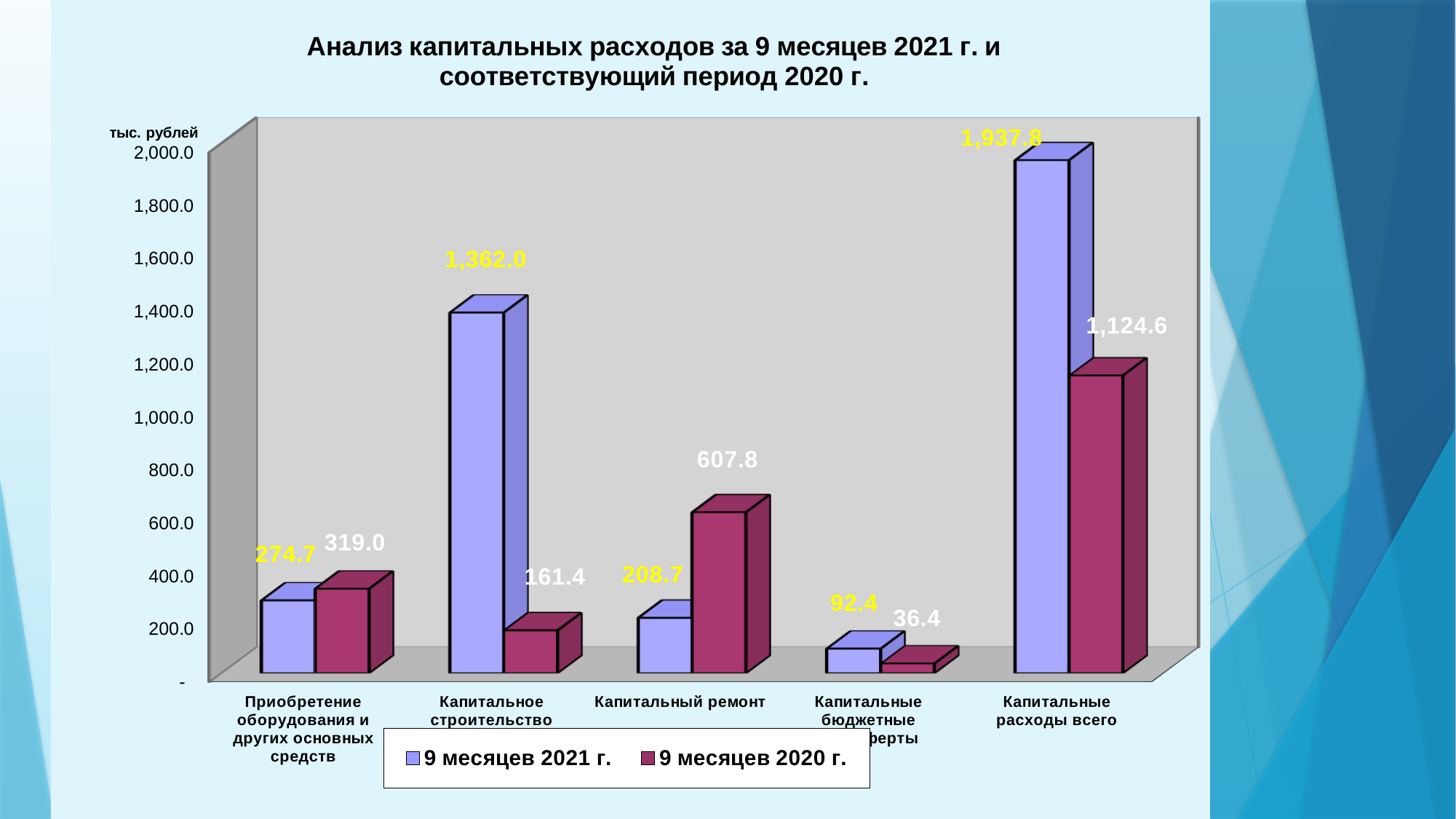
What is the value for "Капитальное строительство" in the "9 месяцев 2021 г." series? 1,362.0 What is the value for "Капитальный ремонт" in the "9 месяцев 2020 г." series? 607.8 What is the value for "Приобретение оборудования и других основных средств" in the "9 месяцев 2021 г." series? 274.7 What is the value for "Капитальные расходы всего" in the "9 месяцев 2020 г." series? 1,124.6 Which category has the highest value in the "9 месяцев 2021 г." series? Капитальные расходы всего How many series does the legend list? 2 What is the difference between the "9 месяцев 2021 г." and "9 месяцев 2020 г." values for "Капитальное строительство"? 1,200.6 What is the difference between the "9 месяцев 2021 г." and "9 месяцев 2020 г." values for "Капитальные расходы всего"? 813.2 Is the "9 месяцев 2021 г." value for "Капитальное строительство" greater or less than 1,400.0? less How many categories are shown on the x axis? 5 What kind of chart is shown on the slide? bar chart For "Приобретение оборудования и других основных средств", which series has the larger value? 9 месяцев 2020 г.